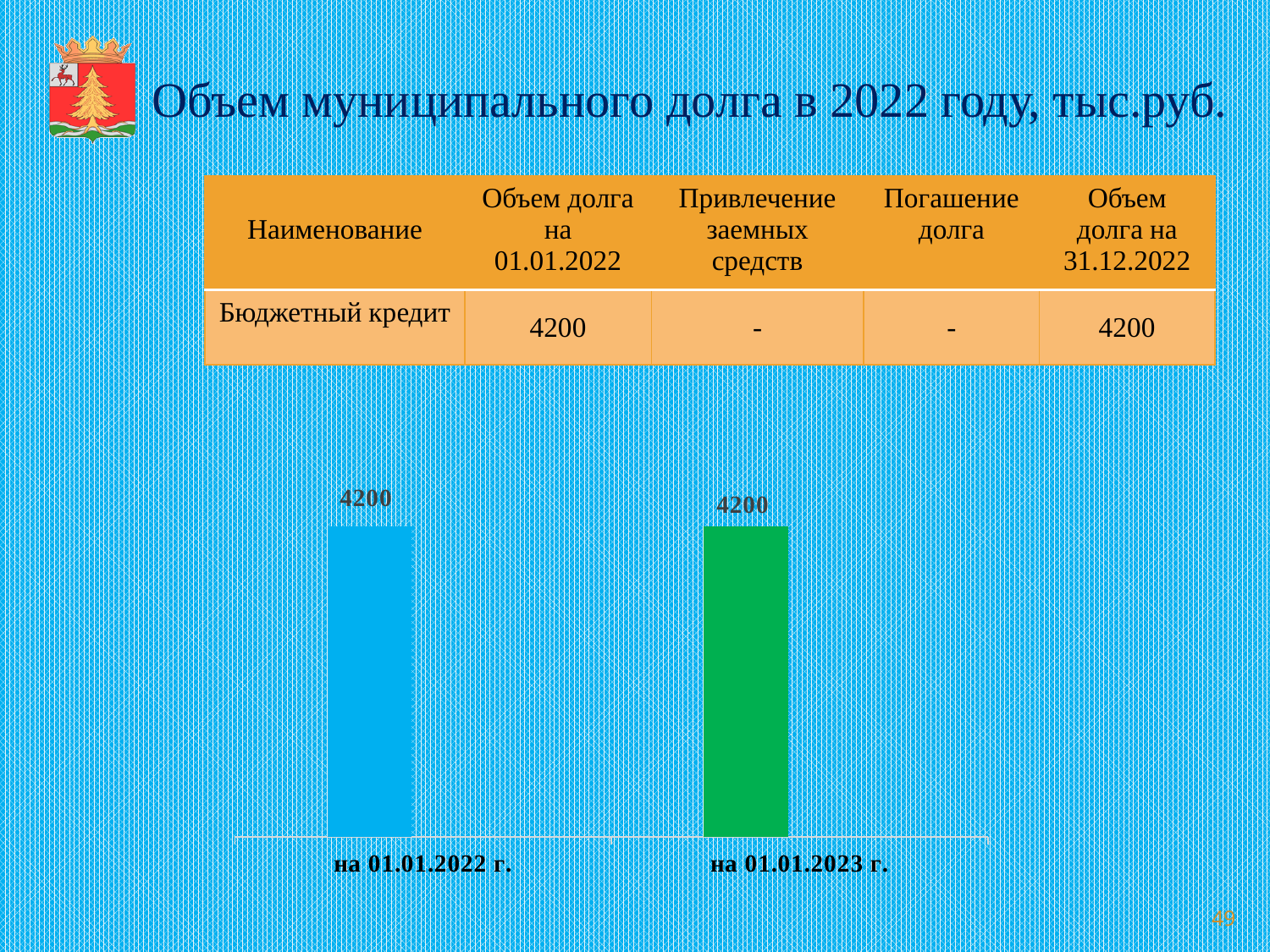
How many bars are shown in the chart? 2 What is the value of the bar for "на 01.01.2022 г."? 4200 What kind of chart is shown on the slide? Bar chart What is the difference between the values for "на 01.01.2022 г." and "на 01.01.2023 г."? 0 Are the values for "на 01.01.2022 г." and "на 01.01.2023 г." equal? Yes Do the values rise, fall or stay the same from "на 01.01.2022 г." to "на 01.01.2023 г."? Stay the same What is the label of the second (right) bar on the x axis? на 01.01.2023 г. What colour is the bar for "на 01.01.2023 г."? Green What is the value of the bar for "на 01.01.2023 г."? 4200 What is the label of the first (left) bar on the x axis? на 01.01.2022 г. What colour is the bar for "на 01.01.2022 г."? Blue